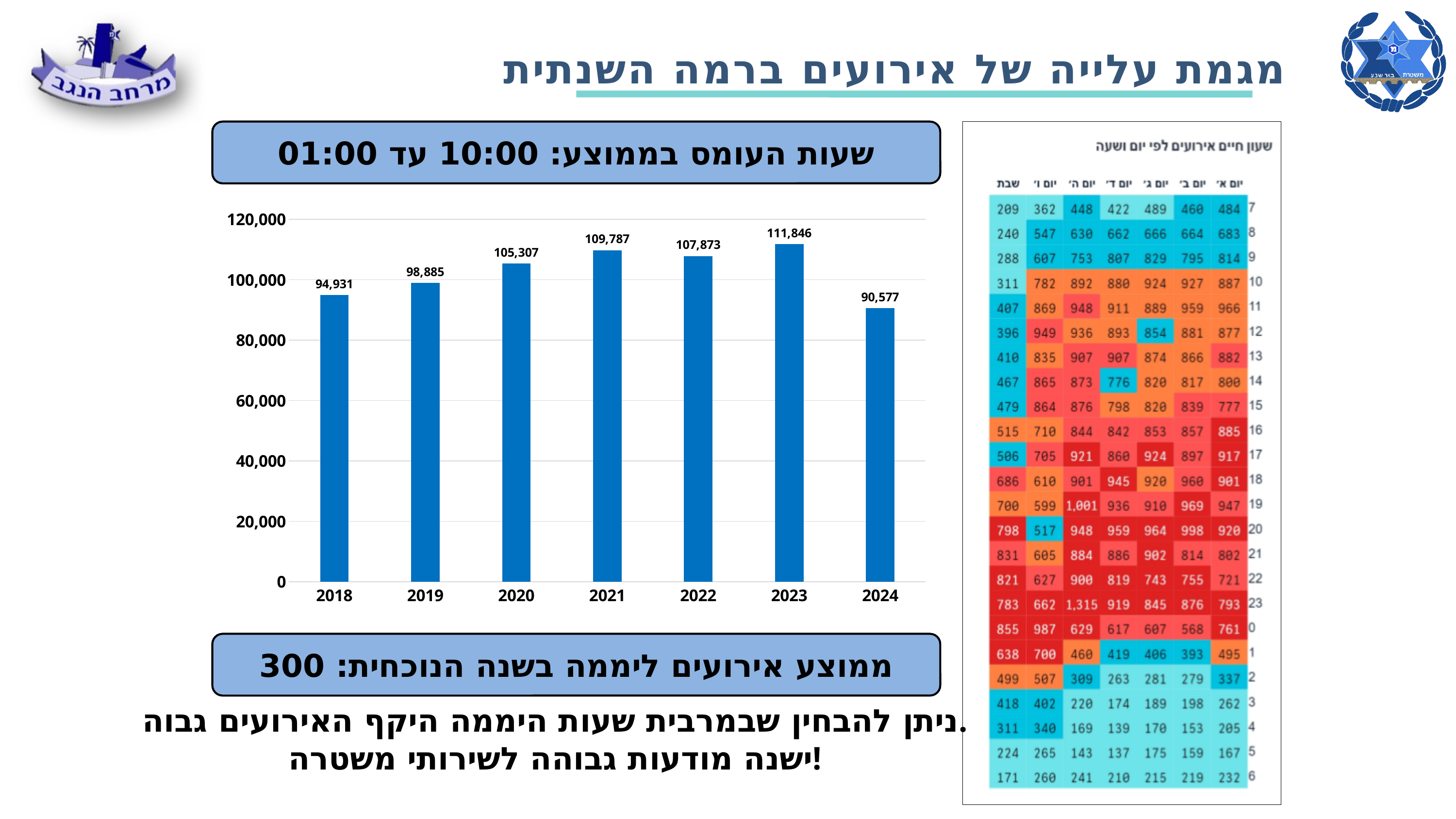
In the bar chart, which is larger, the value for 2021 or the value for 2022? 2021 In the bar chart, which year has the highest value? 2023 In the bar chart, what is the difference between the values for 2023 and 2024? 21,269 In the bar chart, which year has the lowest value? 2024 In the bar chart, do the values rise or fall from 2018 to 2021? rise In the bar chart, what is the difference between the values for 2019 and 2018? 3,954 How many years are shown in the bar chart? 7 In the bar chart, what is the value for 2024? 90,577 What kind of chart is shown on the left of the slide? bar chart In the bar chart, what is the value for 2018? 94,931 In the bar chart, what is the value for 2021? 109,787 In the bar chart, is the value for 2024 greater or less than 100,000? less